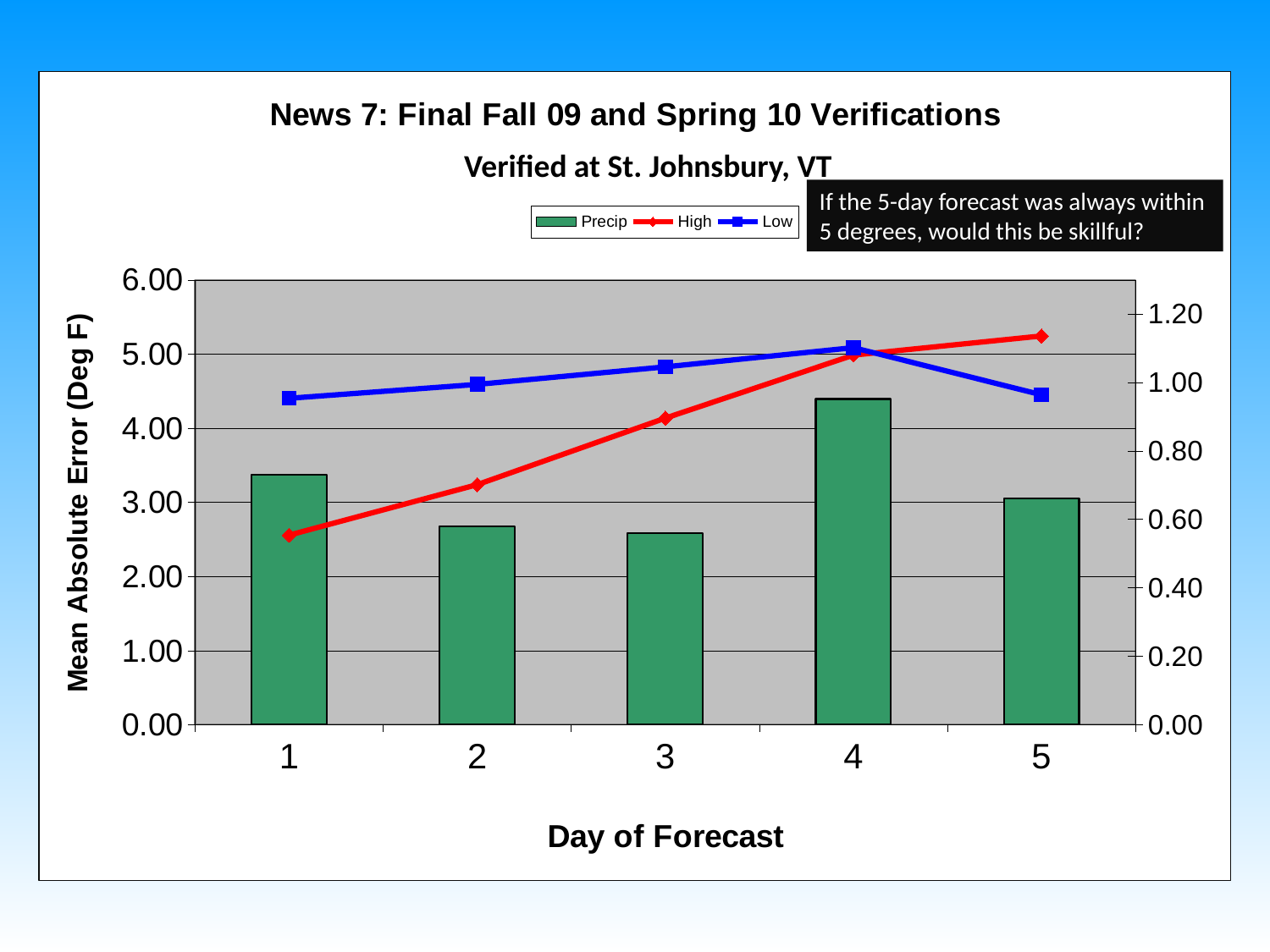
What kind of chart is shown on the slide? A combination bar and line chart What is the label of the x axis? Day of Forecast On which day of forecast is the High line at its lowest value? 1 How many series does the legend list? 3 On which day of forecast does the High line reach its highest value? 5 At day 1, which is larger, the High value or the Low value? Low How many forecast days are shown on the x axis? 5 On which day of forecast does the Low line reach its highest value? 4 On the left axis, is the High value for day 1 greater or less than 3.00? less Does the High line rise or fall from day 1 to day 5? Rise On which day of forecast is the Precip bar the tallest? 4 On the left axis, is the Low value for day 1 greater or less than 5.00? less